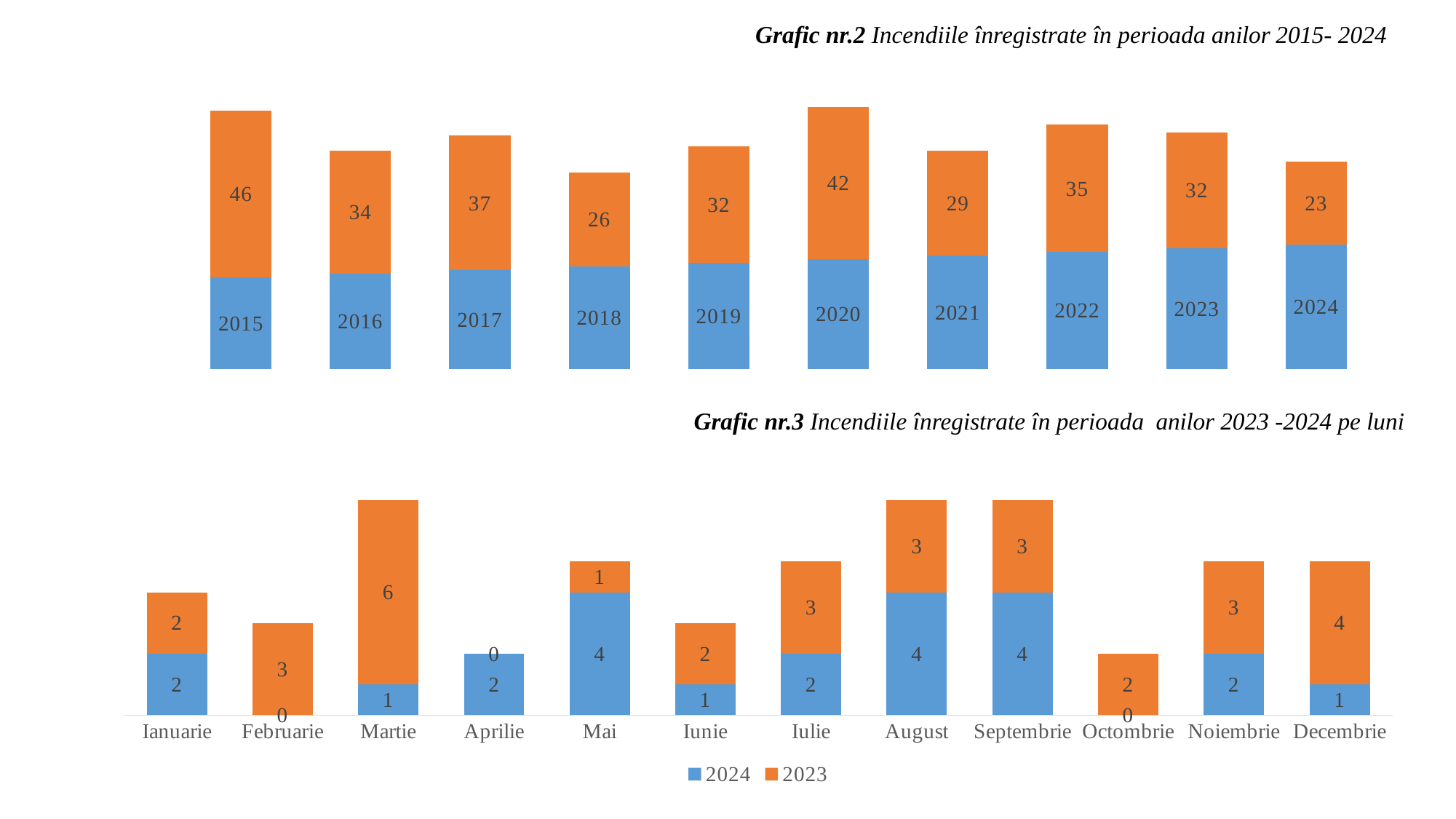
In the chart 'Grafic nr.3', which is larger for Decembrie: the 2024 value or the 2023 value? 2023 In the chart 'Grafic nr.2', what value is shown for 2020? 42 In the chart 'Grafic nr.3', what is the total of the stacked bar for August? 7 In the chart 'Grafic nr.2', how many years are shown? 10 In the chart 'Grafic nr.2', what value is shown for 2015? 46 In the chart 'Grafic nr.2', what is the difference between the values for 2015 and 2018? 20 In the chart 'Grafic nr.3', what is the 2024 value for Mai? 4 In the chart 'Grafic nr.3', what is the 2023 value for Martie? 6 In the chart 'Grafic nr.2', which year has the lowest value? 2024 In the chart 'Grafic nr.2', which year has the highest value? 2015 What type of chart is 'Grafic nr.3'? Stacked bar chart In the chart 'Grafic nr.3', how many series does the legend list? 2